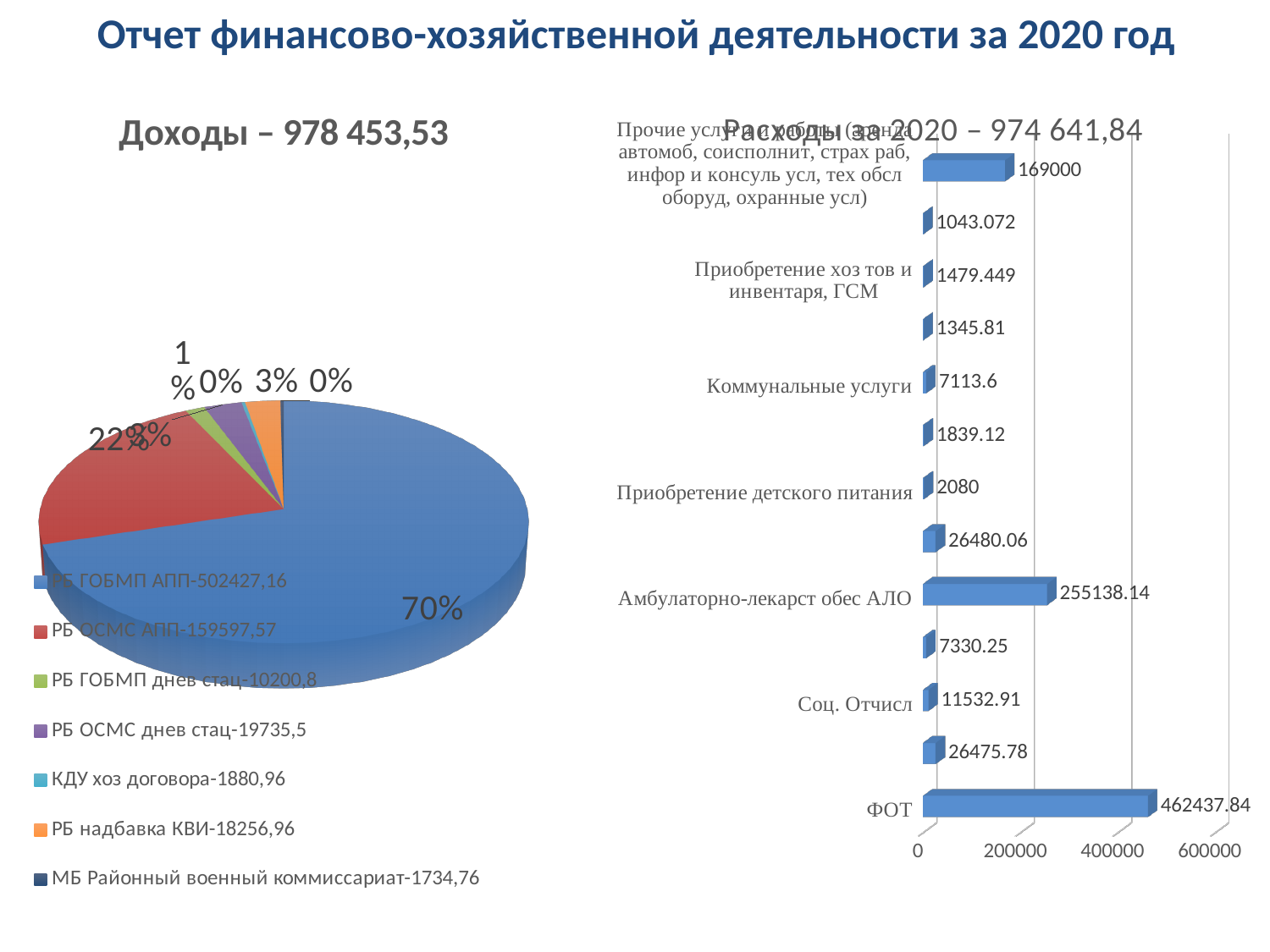
What kind of chart is the chart on the left of the slide (Доходы – 978 453,53)? pie chart In the bar chart on the right, which category has the highest value? ФОТ In the bar chart on the right, what is the difference between the values for ФОТ and Амбулаторно-лекарст обес АЛО? 207299.7 In the bar chart on the right, what is the value for ФОТ? 462437.84 In the pie chart on the left, what share does РБ ГОБМП АПП-502427,16 have? 70% What kind of chart is the chart on the right of the slide (Расходы за 2020)? bar chart In the bar chart on the right, which is larger: ФОТ or Амбулаторно-лекарст обес АЛО? ФОТ In the bar chart on the right, what is the value for Амбулаторно-лекарст обес АЛО? 255138.14 How many entries does the legend of the pie chart on the left list? 7 In the bar chart on the right, what is the value for Приобретение детского питания? 2080 In the bar chart on the right, what is the value for Коммунальные услуги? 7113.6 In the bar chart on the right, is the value for ФОТ greater or less than 400000? greater